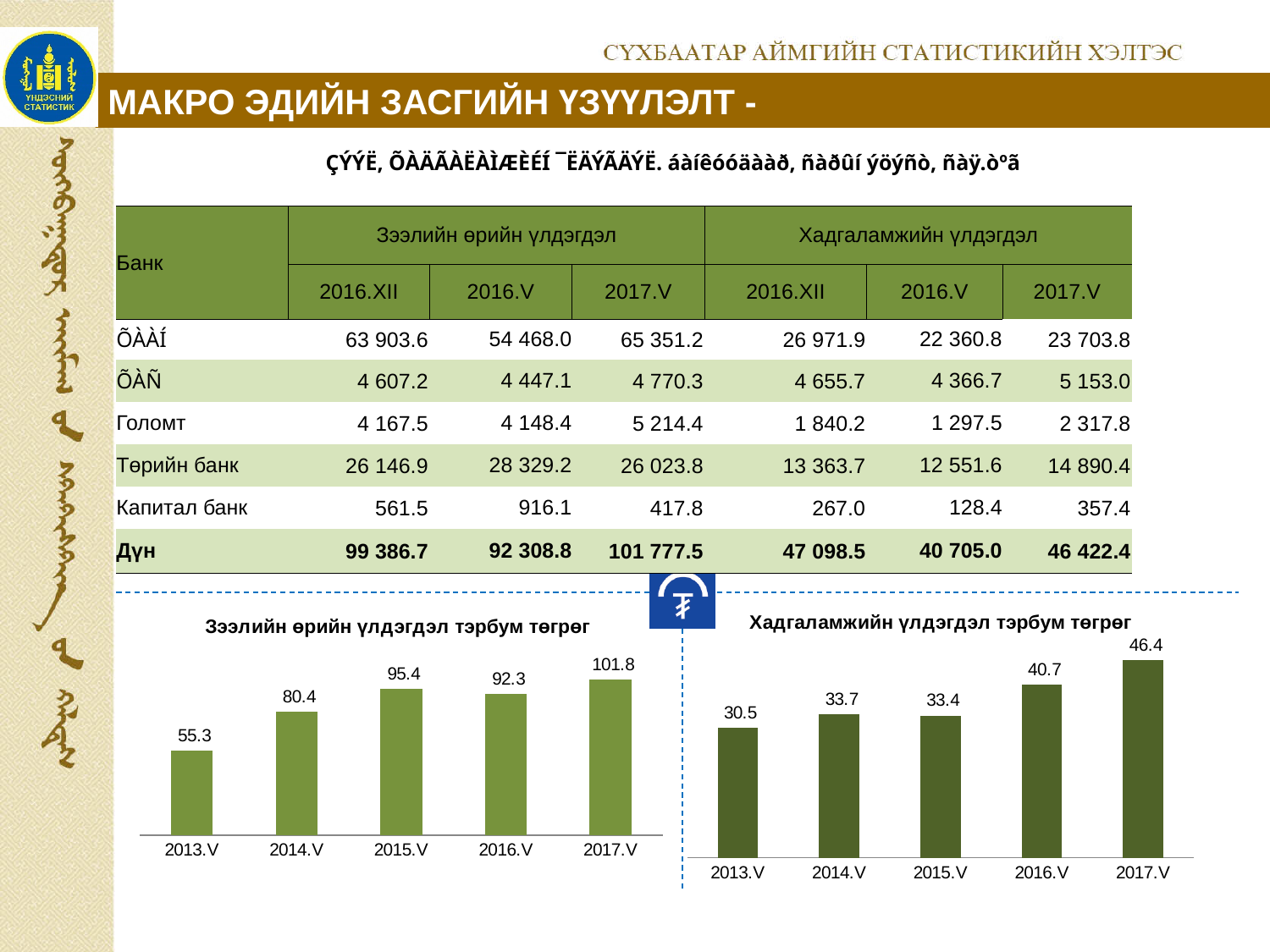
In the left chart 'Зээлийн өрийн үлдэгдэл тэрбум төгрөг', what is the value for 2015.V? 95.4 In the left chart 'Зээлийн өрийн үлдэгдэл тэрбум төгрөг', what is the value for 2013.V? 55.3 In the right chart 'Хадгаламжийн үлдэгдэл тэрбум төгрөг', what is the difference between the values for 2017.V and 2016.V? 5.7 In the left chart 'Зээлийн өрийн үлдэгдэл тэрбум төгрөг', what is the difference between the values for 2017.V and 2013.V? 46.5 In the left chart 'Зээлийн өрийн үлдэгдэл тэрбум төгрөг', which is larger, the value for 2015.V or 2016.V? 2015.V What type of chart is the left chart 'Зээлийн өрийн үлдэгдэл тэрбум төгрөг'? Bar chart In the right chart 'Хадгаламжийн үлдэгдэл тэрбум төгрөг', what is the value for 2014.V? 33.7 How many bars are shown in the right chart 'Хадгаламжийн үлдэгдэл тэрбум төгрөг'? 5 In the right chart 'Хадгаламжийн үлдэгдэл тэрбум төгрөг', which year has the lowest value? 2013.V In the right chart 'Хадгаламжийн үлдэгдэл тэрбум төгрөг', what is the value for 2016.V? 40.7 In the left chart 'Зээлийн өрийн үлдэгдэл тэрбум төгрөг', which year has the highest value? 2017.V In the right chart 'Хадгаламжийн үлдэгдэл тэрбум төгрөг', do the values generally rise or fall from 2013.V to 2017.V? Rise